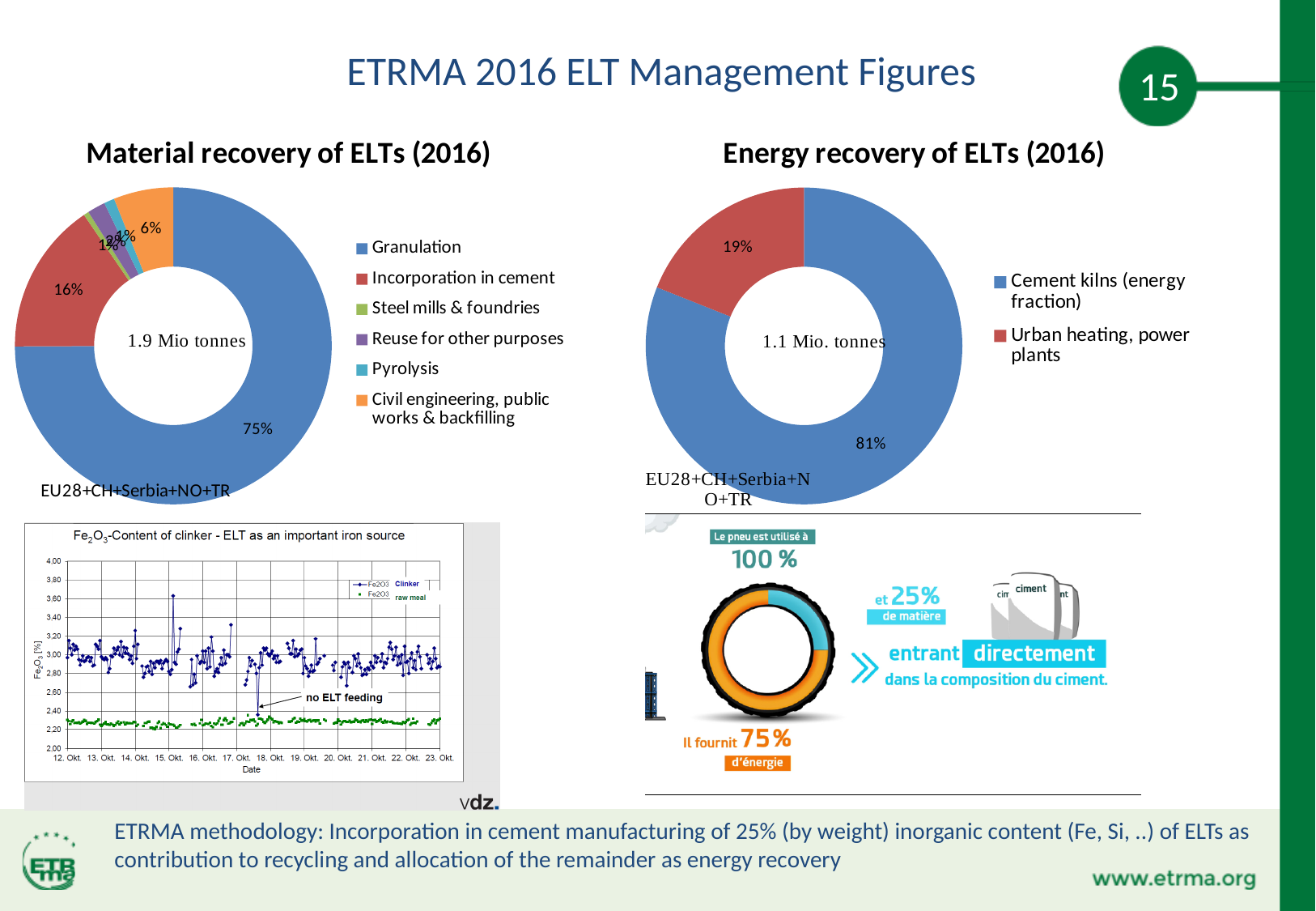
In the Material recovery of ELTs (2016) chart, what share is Granulation? 75% In the Material recovery of ELTs (2016) chart, what share is Civil engineering, public works & backfilling? 6% In the Energy recovery of ELTs (2016) chart, what share is Cement kilns (energy fraction)? 81% In the Energy recovery of ELTs (2016) chart, what is the difference in percentage points between Cement kilns (energy fraction) and Urban heating, power plants? 62 In the Energy recovery of ELTs (2016) chart, what total quantity is shown in the centre of the donut? 1.1 Mio. tonnes What kind of chart is the Energy recovery of ELTs (2016) chart? Pie (donut) chart In the Material recovery of ELTs (2016) chart, what share is Incorporation in cement? 16% How many entries does the legend of the Material recovery of ELTs (2016) chart list? 6 In the Material recovery of ELTs (2016) chart, what total quantity is shown in the centre of the donut? 1.9 Mio tonnes In the Material recovery of ELTs (2016) chart, which category has the largest share? Granulation In the Fe2O3-Content of clinker chart at the bottom left, are the Fe2O3 raw meal values greater or less than 2.60? less In the Energy recovery of ELTs (2016) chart, what share is Urban heating, power plants? 19%